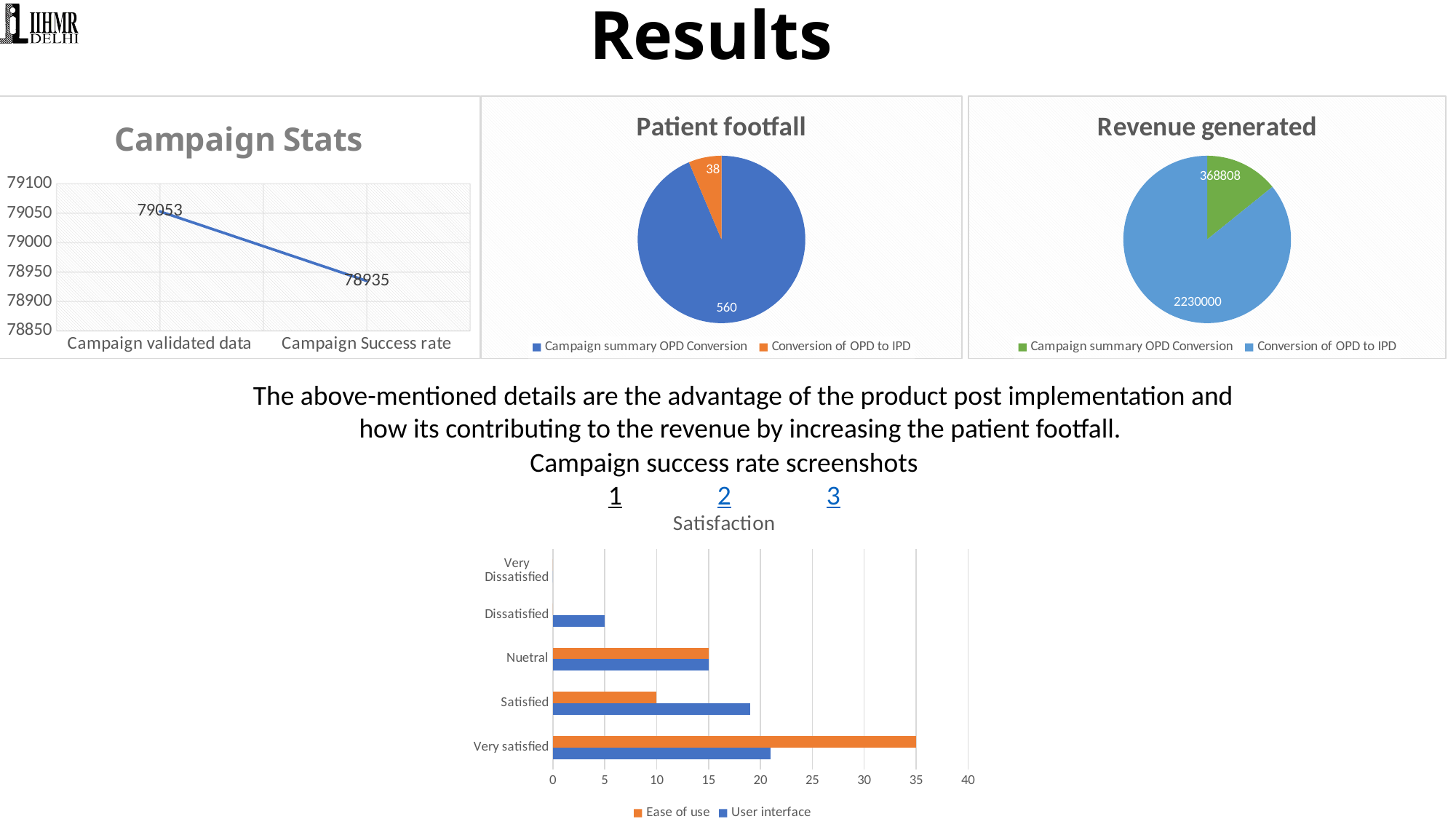
In the Campaign Stats chart, what is the value for Campaign Success rate? 78935 In the Satisfaction chart, what is the Ease of use value for Very satisfied? 35 In the Revenue generated pie chart, what is the value for Conversion of OPD to IPD? 2230000 In the Satisfaction chart, is the User interface value for Very satisfied greater or less than 25? less In the Campaign Stats chart, what is the value for Campaign validated data? 79053 In the Campaign Stats chart, does the line rise or fall from Campaign validated data to Campaign Success rate? fall What kind of chart is the Satisfaction chart? bar chart How many series does the legend of the Satisfaction chart list? 2 In the Revenue generated pie chart, which slice is larger, Campaign summary OPD Conversion or Conversion of OPD to IPD? Conversion of OPD to IPD In the Patient footfall pie chart, what is the value for Conversion of OPD to IPD? 38 In the Campaign Stats chart, what is the difference between Campaign validated data and Campaign Success rate? 118 In the Patient footfall pie chart, what is the total of the two slices? 598